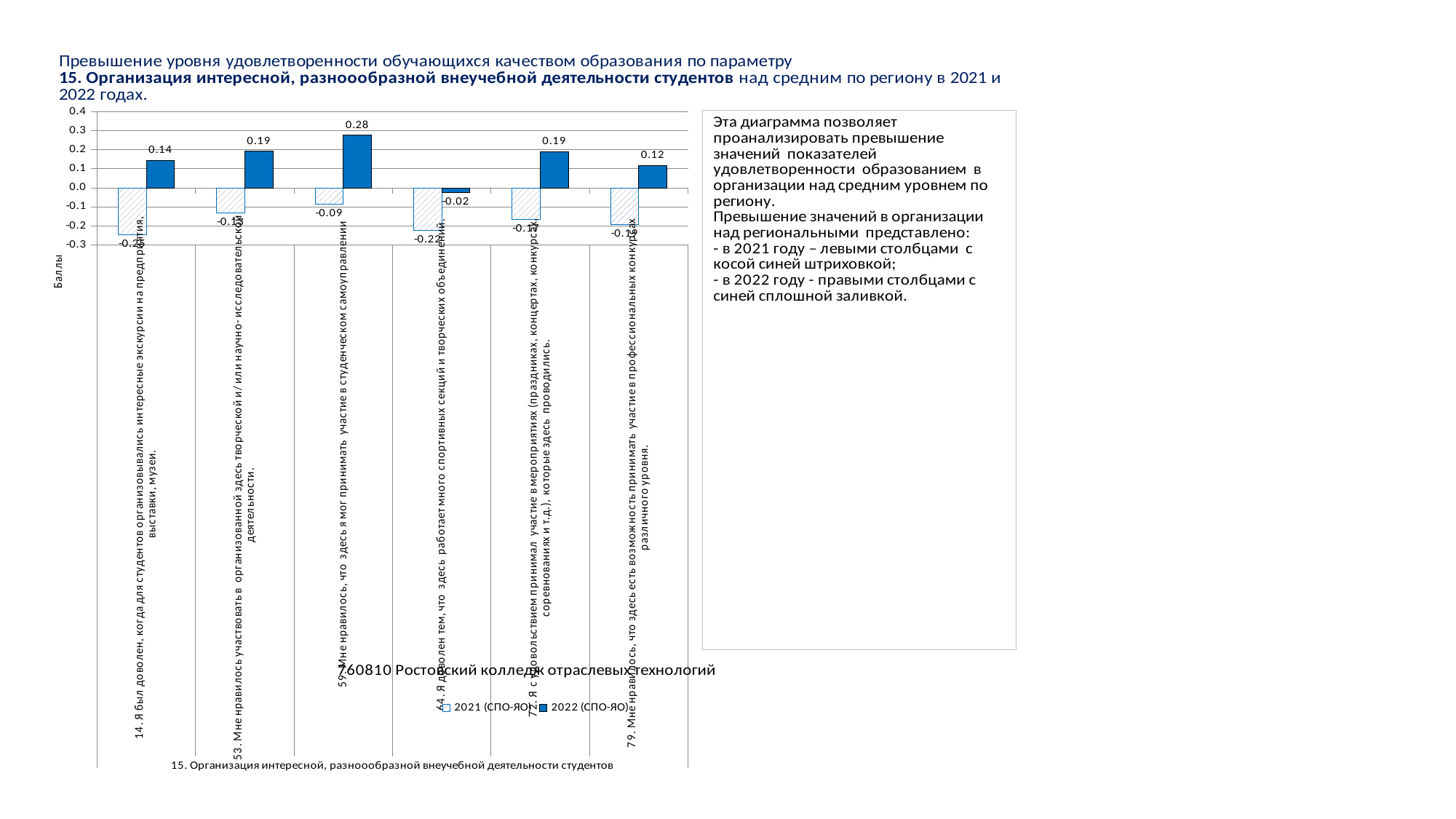
What is the 2022 (СПО-ЯО) value for statement 59 (participation in student self-government)? 0.28 What is the 2021 (СПО-ЯО) value for statement 64 (many sports sections and creative associations)? -0.22 Is the 2021 (СПО-ЯО) value for statement 53 greater or less than -0.2? greater How many categories (statements) are plotted on the x axis of the chart? 6 Which statement has the lowest 2022 (СПО-ЯО) value? 64. Я доволен тем, что здесь работает много спортивных секций и творческих объединений What is the 2022 (СПО-ЯО) value for statement 64 (many sports sections and creative associations)? -0.02 Which has the larger 2022 (СПО-ЯО) value: statement 14 or statement 79? Statement 14 What type of chart is shown on the slide? Bar chart Which statement has the highest 2022 (СПО-ЯО) value? 59. Мне нравилось, что здесь я мог принимать участие в студенческом самоуправлении What is the 2021 (СПО-ЯО) value for statement 59 (participation in student self-government)? -0.09 How many series does the chart legend list? 2 What is the difference between the 2022 values for statement 59 (0.28) and statement 14 (0.14)? 0.14